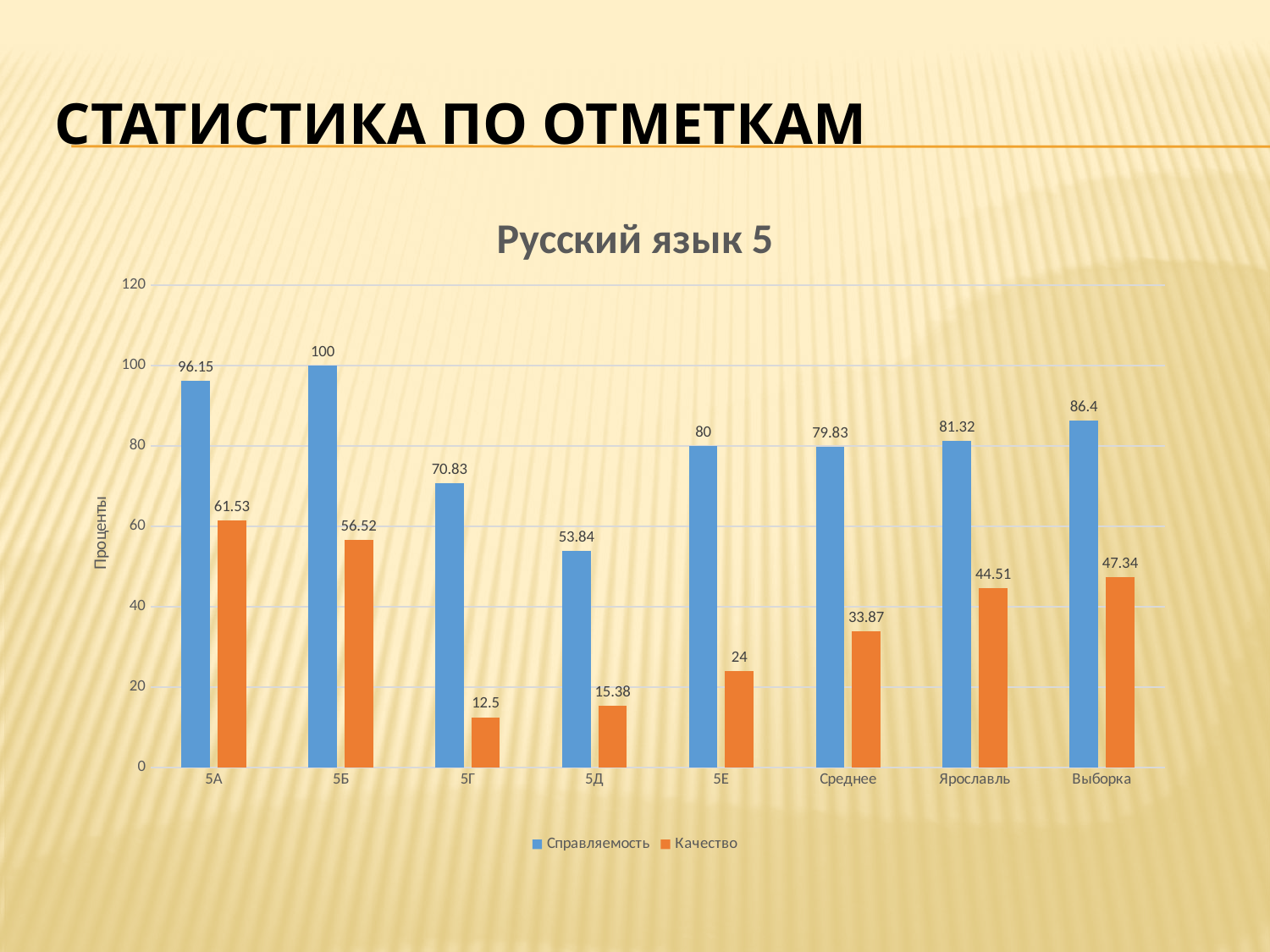
What is the Справляемость value for Ярославль? 81.32 How many series does the legend list? 2 What is the title of the chart? Русский язык 5 Which is larger, the Качество value for Среднее or for Выборка? Выборка What is the Качество value for 5Г? 12.5 What kind of chart is shown? bar chart Which category has the highest Качество value? 5А Which category has the lowest Справляемость value? 5Д Is the Справляемость value for 5Г greater or less than 80? less How many categories are shown on the x axis? 8 What is the difference between the Справляемость and Качество values for 5Е? 56 What is the Справляемость value for 5Б? 100